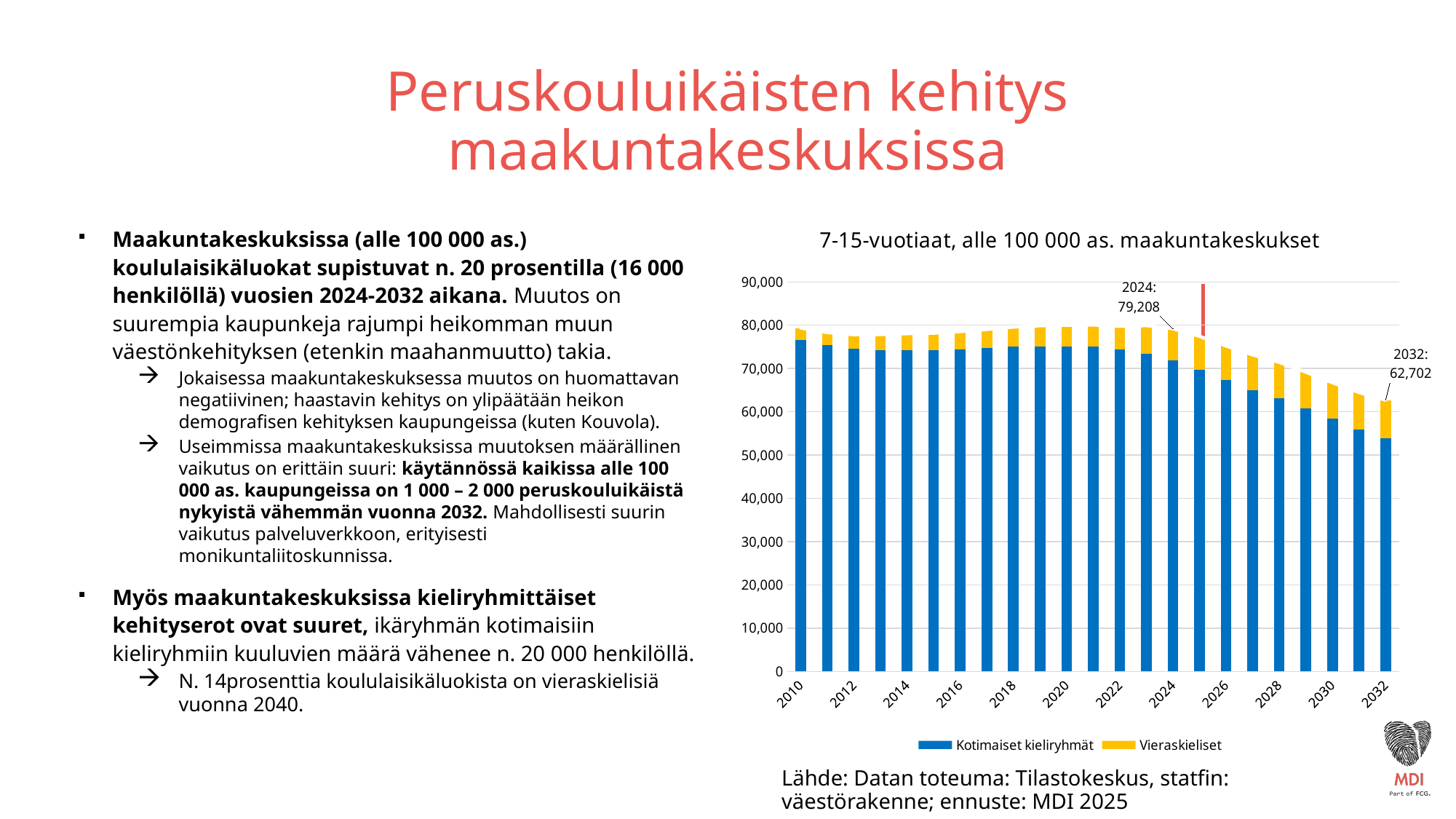
What is the title of the chart? 7-15-vuotiaat, alle 100 000 as. maakuntakeskukset What is the total value labelled for the year 2032? 62,702 Is the value for Kotimaiset kieliryhmät in 2032 greater or less than 60,000? less What are the two series named in the chart legend? Kotimaiset kieliryhmät and Vieraskieliset How many series does the chart legend list? 2 What is the total value labelled for the year 2024? 79,208 Which year has the lowest total bar in the chart? 2032 How many years (bars) are plotted in the chart? 23 Which year has the larger labelled total, 2024 or 2032? 2024 Do the total bar values rise or fall from 2024 to 2032? Fall What kind of chart is shown on the slide? Stacked bar chart What is the difference between the labelled totals for 2024 and 2032? 16,506